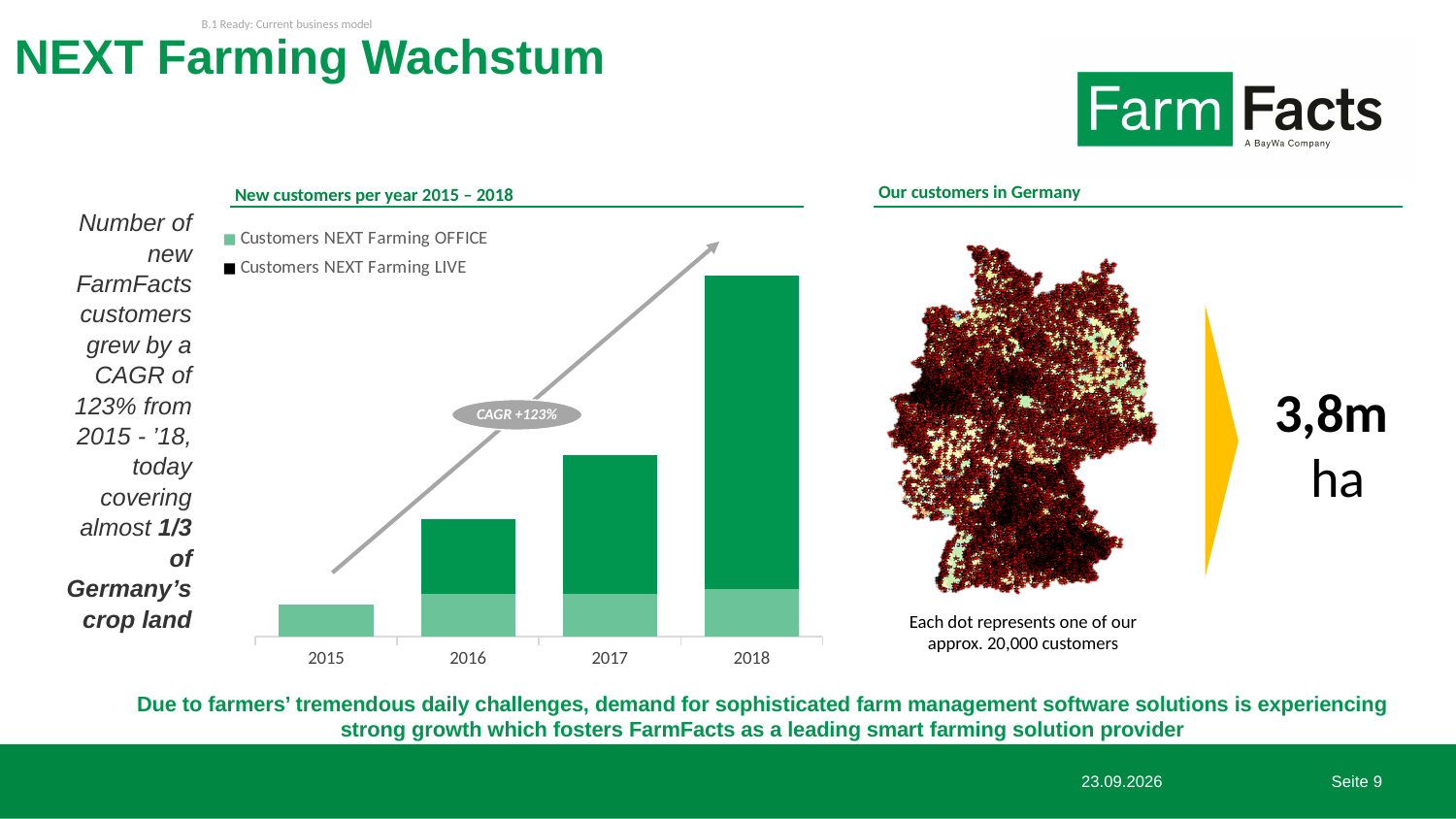
How many series does the legend of the "New customers per year 2015 – 2018" chart list? 2 In the "New customers per year 2015 – 2018" chart, which year has no Customers NEXT Farming LIVE segment? 2015 In the "New customers per year 2015 – 2018" chart, do the total bar heights rise or fall from 2015 to 2018? Rise Which year has the shortest stacked bar in the "New customers per year 2015 – 2018" chart? 2015 Which year has the tallest stacked bar in the "New customers per year 2015 – 2018" chart? 2018 In the "New customers per year 2015 – 2018" chart, which series is shown in dark green? Customers NEXT Farming LIVE In the "New customers per year 2015 – 2018" chart, which series forms the larger part of the 2018 bar? Customers NEXT Farming LIVE What kind of chart is shown under the heading "New customers per year 2015 – 2018"? Stacked bar chart In the "New customers per year 2015 – 2018" chart, is the total bar for 2017 taller or shorter than the total bar for 2016? Taller What is the first year shown on the x axis of the "New customers per year 2015 – 2018" chart? 2015 What CAGR is annotated on the arrow in the "New customers per year 2015 – 2018" chart? CAGR +123% How many years are shown on the x axis of the "New customers per year 2015 – 2018" chart? 4